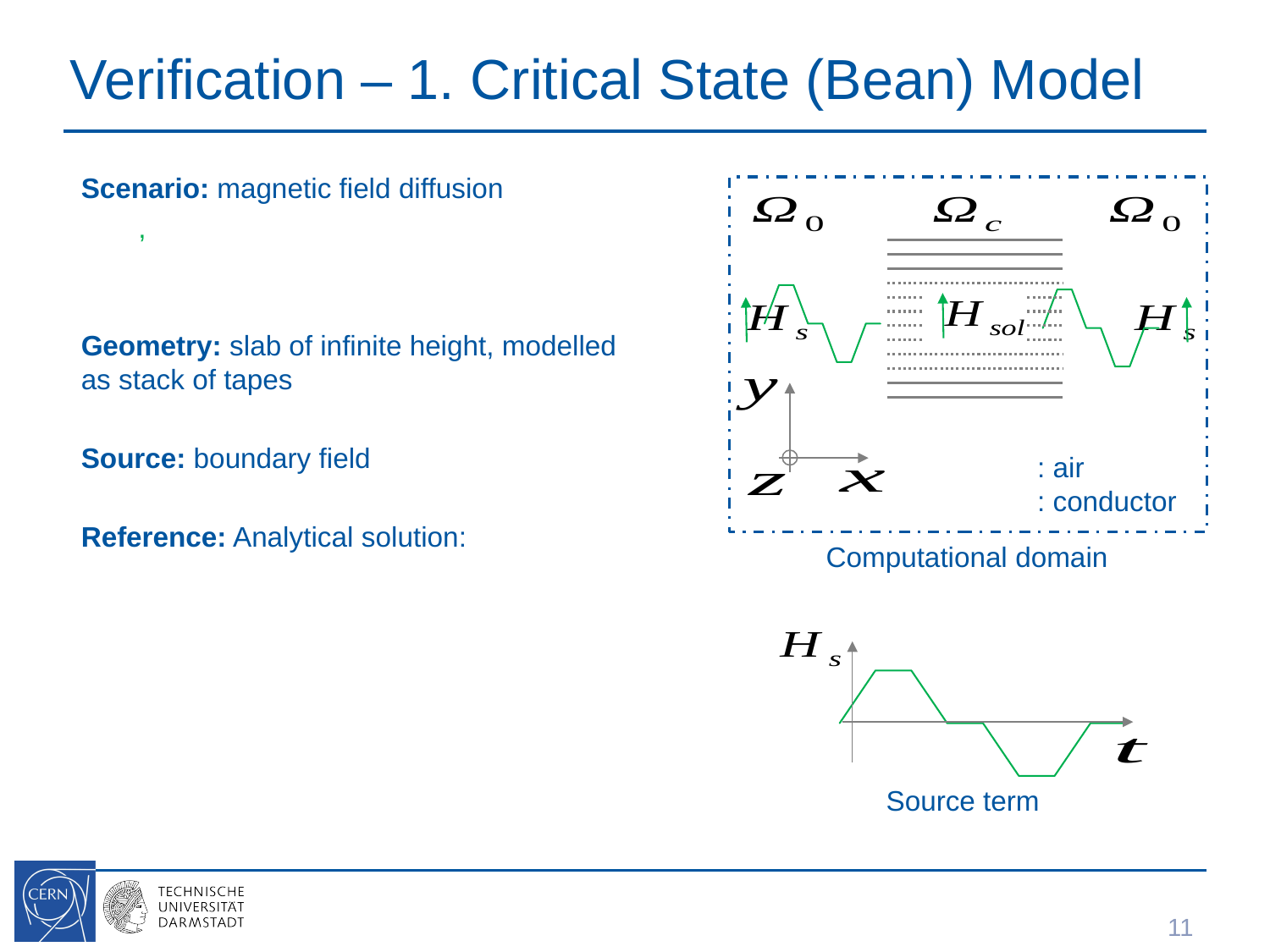
In the 'Source term' plot, what is the label on the vertical axis? Hs In the 'Source term' plot, does the curve initially rise or fall from the origin along the t axis? rise In the 'Source term' plot, what is the label on the horizontal axis? t What kind of chart is the 'Source term' plot at the bottom right of the slide? line chart